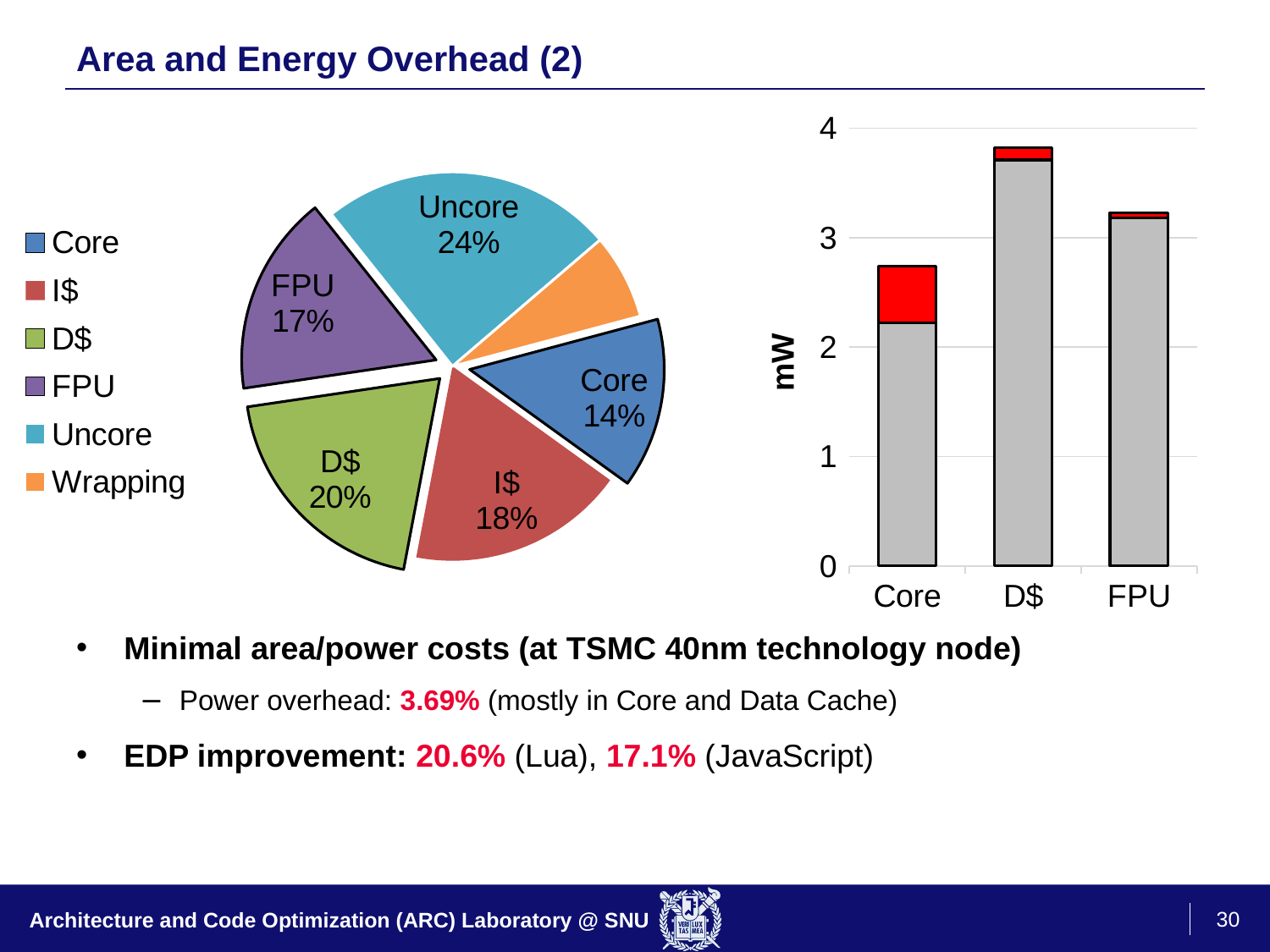
How many entries does the legend of the pie chart list? 6 In the pie chart, which component has the smallest slice? Wrapping In the pie chart, what share does D$ account for? 20% What kind of chart is the chart on the right side of the slide? Bar chart What unit is shown on the y axis of the bar chart on the right? mW In the bar chart on the right, is the total value for Core greater or less than 3? less How many categories are shown on the x axis of the bar chart on the right? 3 In the pie chart, what share does Uncore account for? 24% In the pie chart, what is the difference in percentage points between the D$ share and the Core share? 6 percentage points In the bar chart on the right, which category has the tallest bar? D$ In the pie chart, which component has the largest share? Uncore In the pie chart, which has the larger share, I$ or FPU? I$